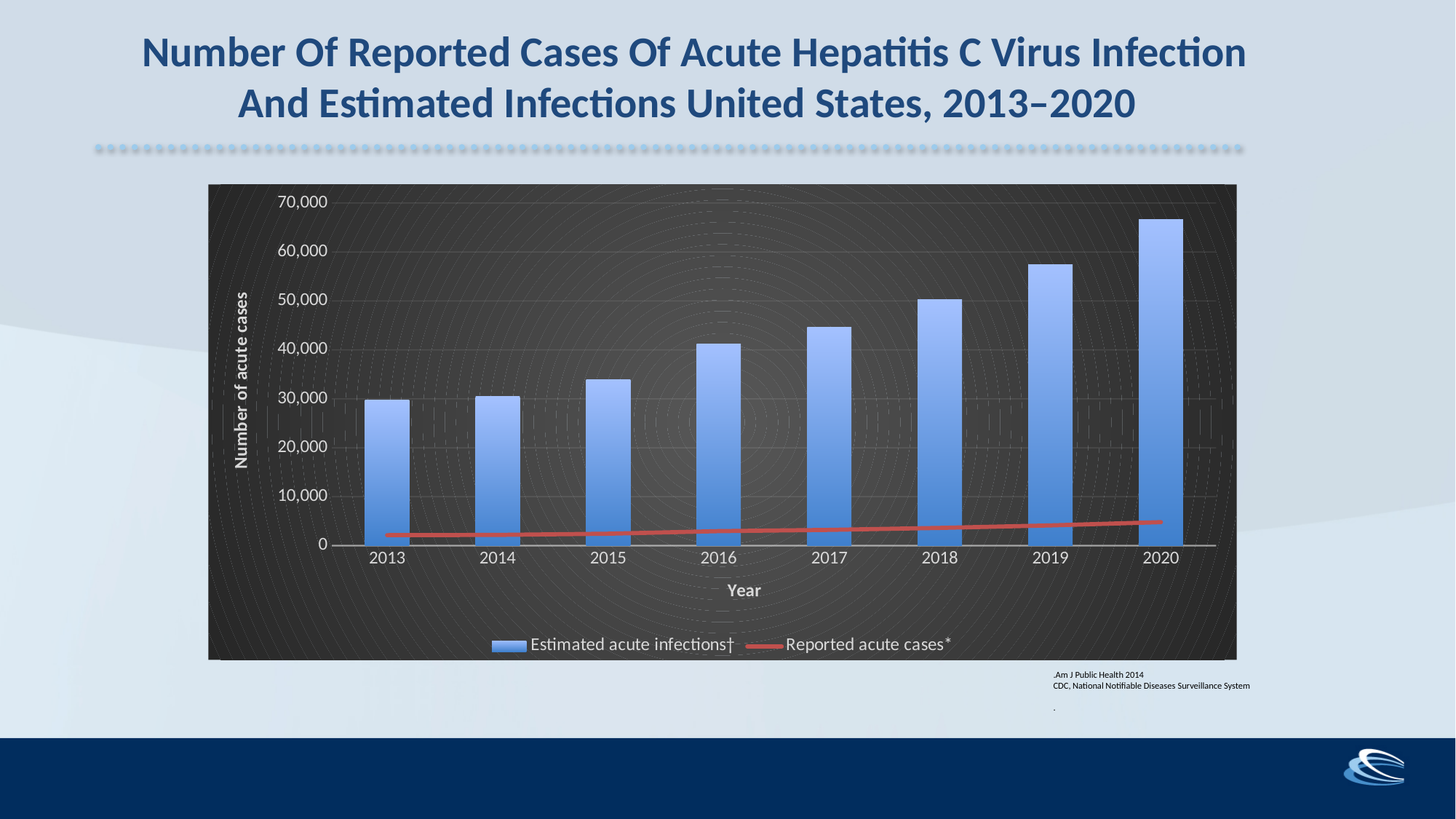
Do the estimated acute infections rise or fall from 2013 to 2020? Rise Is the value for estimated acute infections in 2020 greater or less than 60,000? greater How many years are shown along the x axis? 8 What kind of chart is shown on the slide? Bar chart with a line series Which year has the highest estimated acute infections? 2020 What is the label on the y axis? Number of acute cases Which series is drawn as a red line? Reported acute cases* Which year has the lowest estimated acute infections? 2013 How many series does the legend list? 2 Which is larger, the estimated acute infections in 2018 or in 2015? 2018